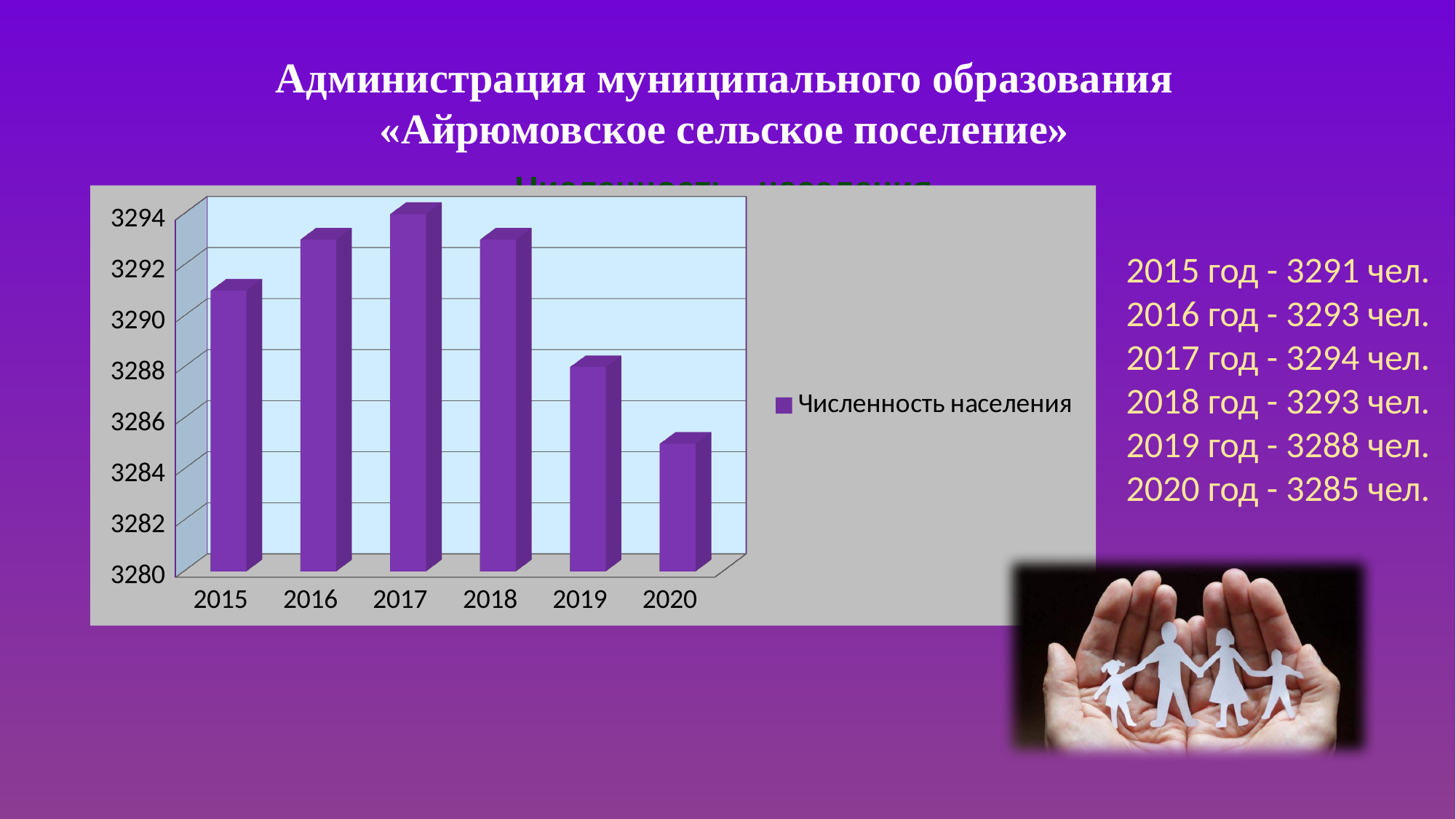
What is the population value for 2019? 3288 чел. What is the population value for 2017? 3294 чел. What is the name of the series in the chart legend? Численность населения Which year has the lowest population in the chart? 2020 What is the population value for 2020? 3285 чел. Which year has the highest population in the chart? 2017 How many series does the chart legend list? 1 What is the difference between the population in 2017 and in 2020? 9 Is the value for 2016 greater or less than 3290? greater What type of chart is shown on the slide? bar chart Which year has a larger population, 2015 or 2019? 2015 How many years are shown on the x axis of the chart? 6